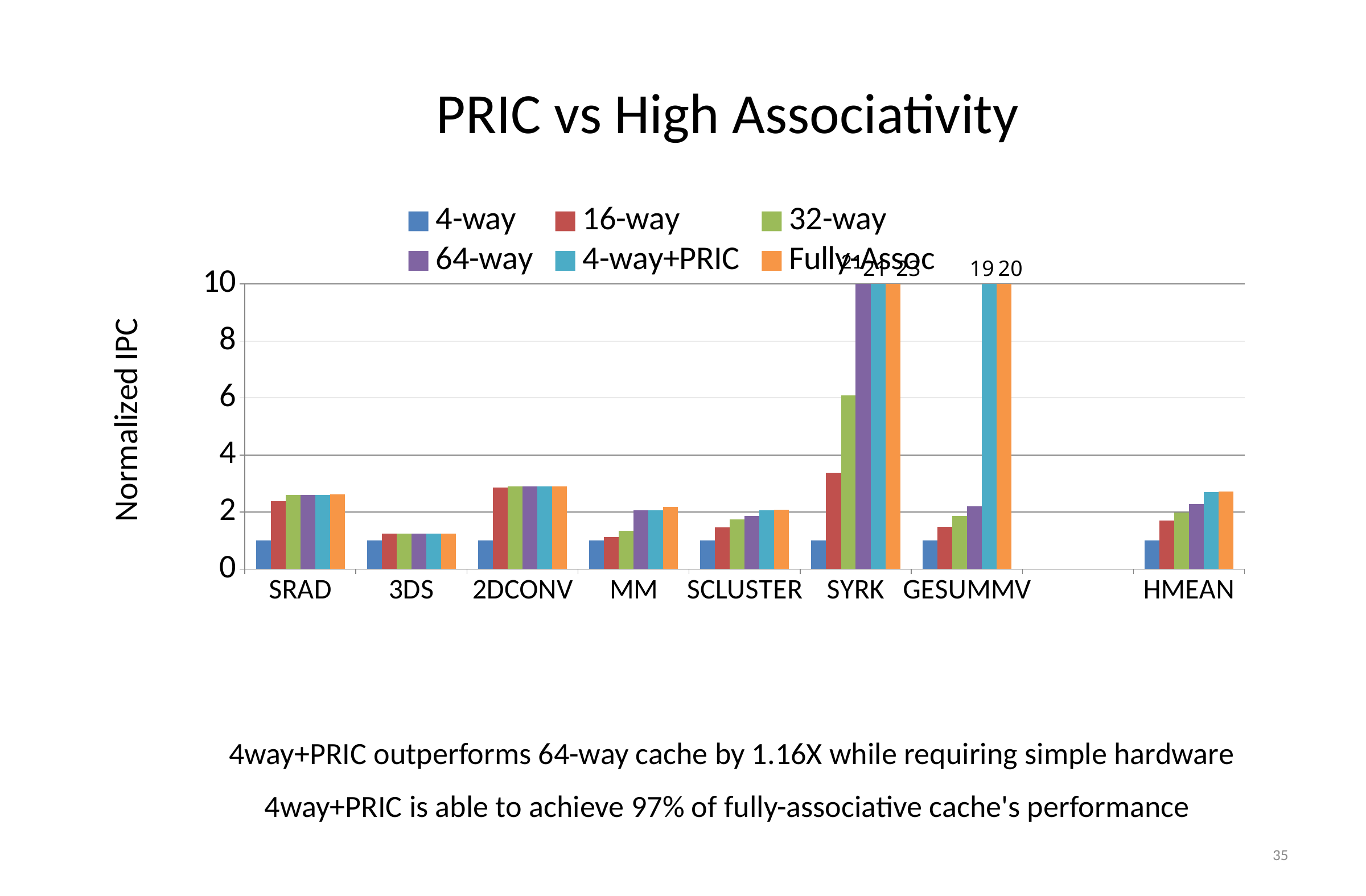
What is the Fully-Assoc value for GESUMMV? 20 What kind of chart is shown on the slide? bar chart Is the 16-way value for 3DS greater or less than 2? less What is the title of the y axis? Normalized IPC For SYRK, which is larger: the 16-way value or the 32-way value? 32-way What is the difference between the Fully-Assoc and 4-way+PRIC values for GESUMMV? 1 How many series does the legend list? 6 What is the Fully-Assoc value for SYRK? 23 Is the 32-way value for SYRK greater or less than 4? greater What is the 4-way+PRIC value for GESUMMV? 19 How many categories are shown on the x axis? 8 Which category has the highest Fully-Assoc value? SYRK